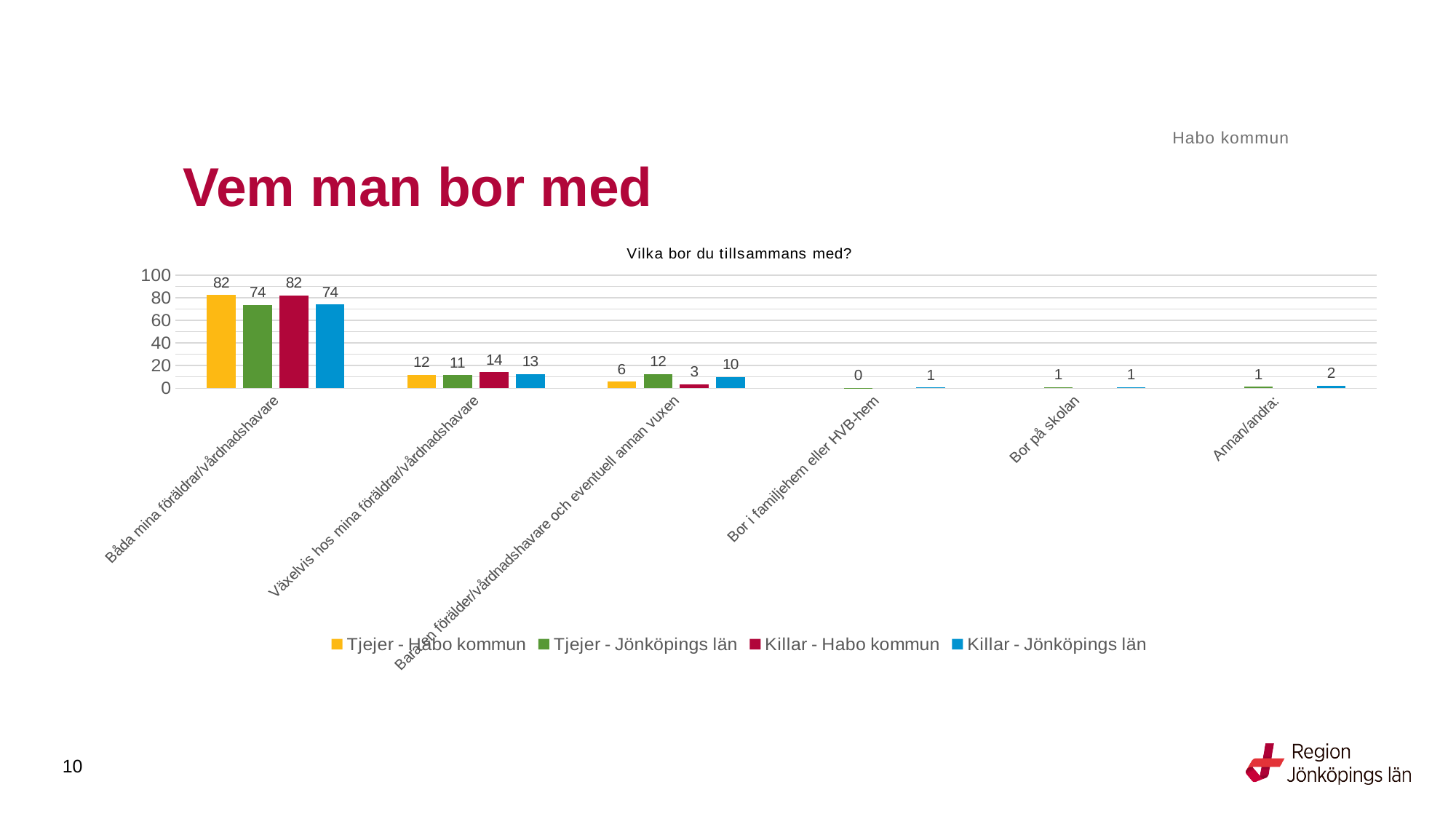
What is the difference between Tjejer - Habo kommun and Tjejer - Jönköpings län in the category 'Båda mina föräldrar/vårdnadshavare'? 8 What is the title of the chart? Vilka bor du tillsammans med? Which category has the highest value for Killar - Habo kommun? Båda mina föräldrar/vårdnadshavare What is the value for Killar - Jönköpings län in the category 'Annan/andra'? 2 Is the value for Killar - Habo kommun in 'Båda mina föräldrar/vårdnadshavare' greater or less than 60? greater What is the value for Killar - Jönköpings län in the category 'Växelvis hos mina föräldrar/vårdnadshavare'? 13 In the category 'Bara en förälder/vårdnadshavare och eventuell annan vuxen', which is larger: Tjejer - Habo kommun or Killar - Habo kommun? Tjejer - Habo kommun How many categories are shown on the x axis? 6 What is the value for Tjejer - Habo kommun in the category 'Båda mina föräldrar/vårdnadshavare'? 82 What kind of chart is shown on the slide? bar chart How many series does the legend list? 4 What is the value for Tjejer - Jönköpings län in the category 'Bara en förälder/vårdnadshavare och eventuell annan vuxen'? 12